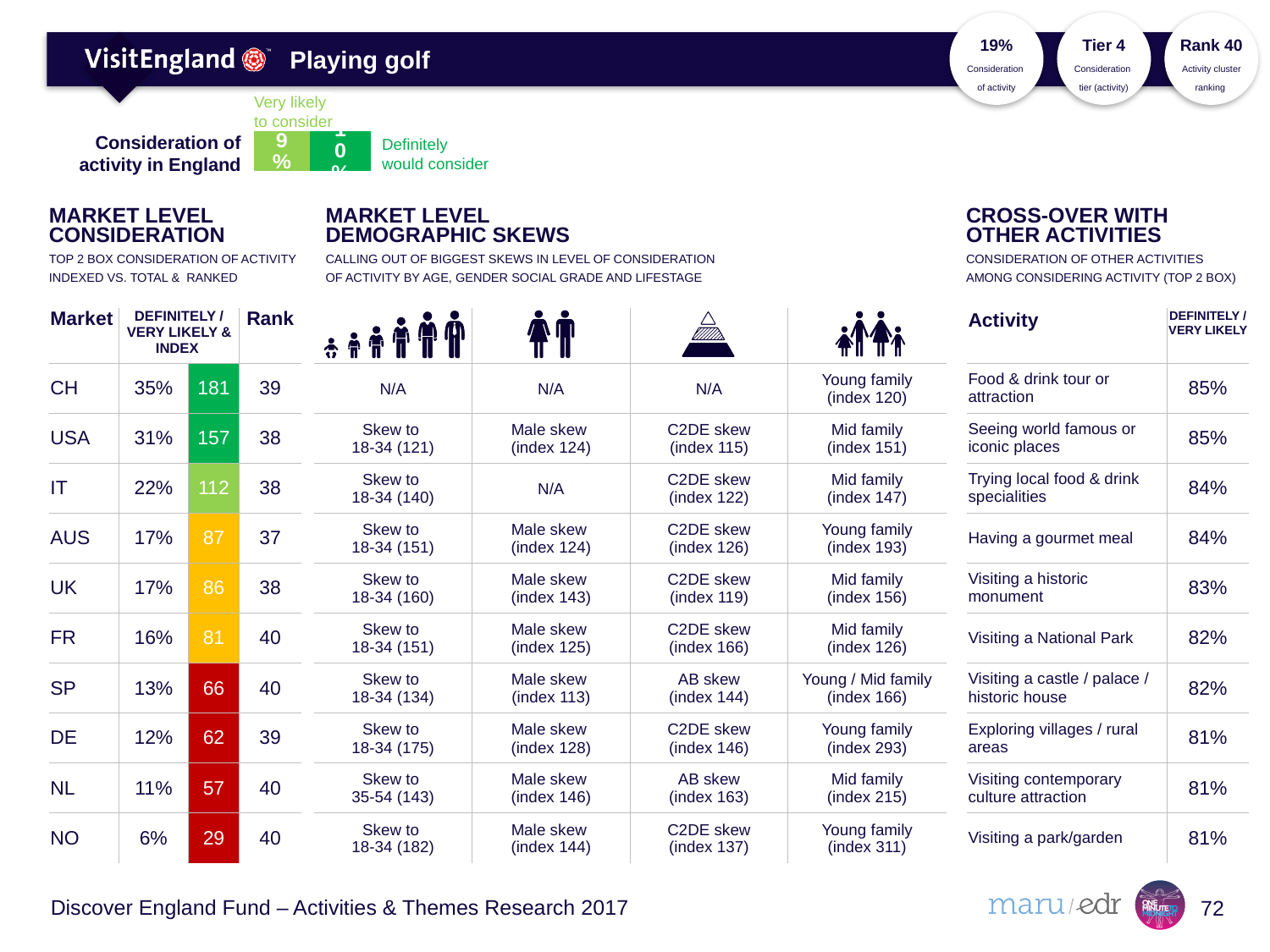
In the 'Consideration of activity in England' chart, which segment is shown in green? Very likely to consider In the 'Consideration of activity in England' chart, what is the value for 'Very likely to consider'? 9% What kind of chart is the 'Consideration of activity in England' chart? bar chart What are the two segment labels in the 'Consideration of activity in England' chart? Very likely to consider; Definitely would consider How many segments (series) does the 'Consideration of activity in England' bar chart show? 2